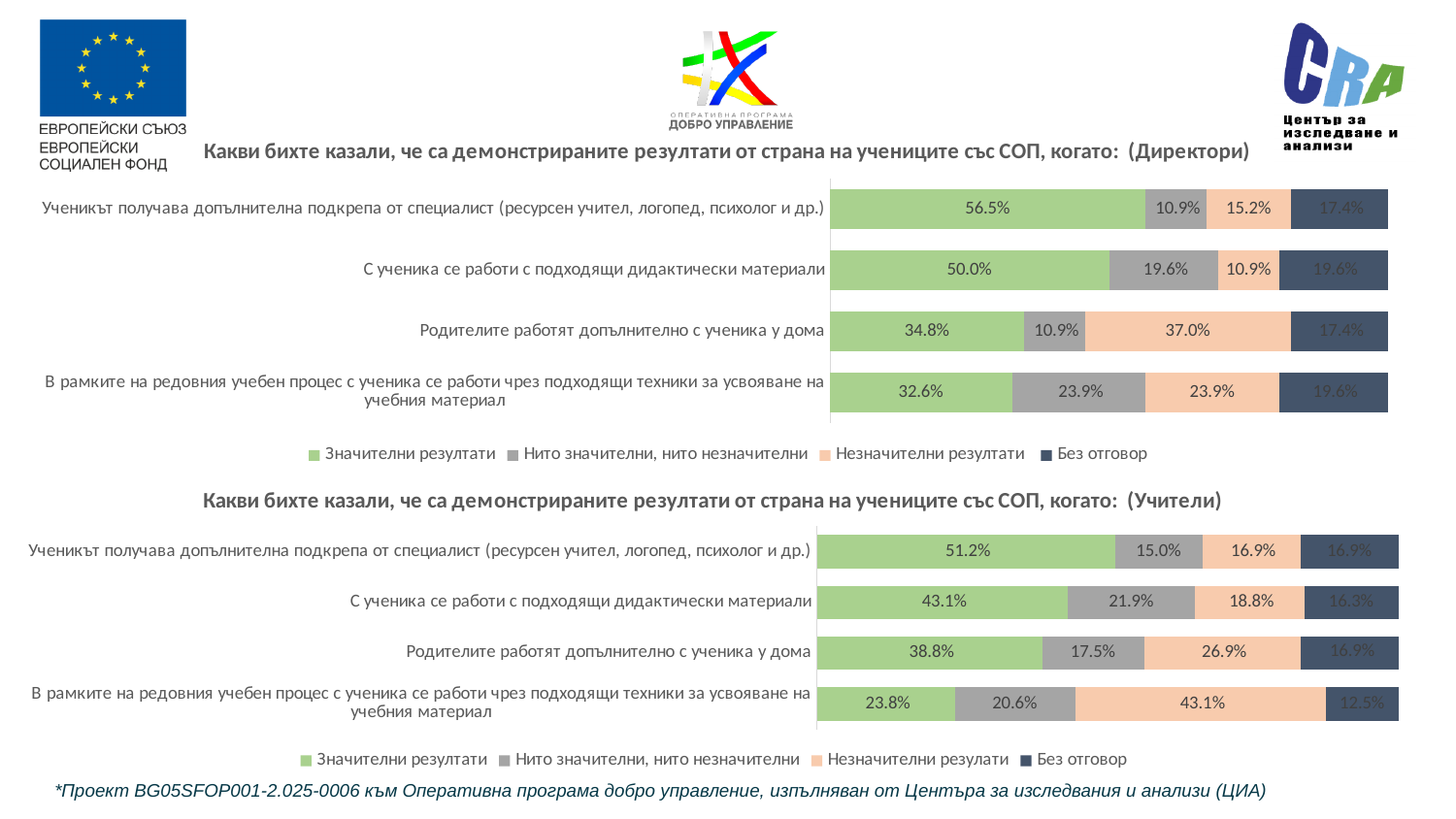
In the chart titled "(Учители)", which is larger for "Родителите работят допълнително с ученика у дома": "Значителни резултати" or "Незначителни резултати"? Значителни резултати In the chart titled "(Учители)", what is the value of "Незначителни резултати" for "В рамките на редовния учебен процес с ученика се работи чрез подходящи техники за усвояване на учебния материал"? 43.1% In the chart titled "(Учители)", what is the value of "Без отговор" for "С ученика се работи с подходящи дидактически материали"? 16.3% In the chart titled "(Учители)", which category has the lowest value for "Значителни резултати"? В рамките на редовния учебен процес с ученика се работи чрез подходящи техники за усвояване на учебния материал In the chart titled "(Учители)", what is the difference between the "Незначителни резултати" values for "В рамките на редовния учебен процес с ученика се работи чрез подходящи техники за усвояване на учебния материал" and "Ученикът получава допълнителна подкрепа от специалист (ресурсен учител, логопед, психолог и др.)"? 26.2% In the chart titled "(Директори)", what is the value of "Нито значителни, нито незначителни" for "В рамките на редовния учебен процес с ученика се работи чрез подходящи техники за усвояване на учебния материал"? 23.9% What kind of chart is the chart titled "(Директори)"? Stacked bar chart In the chart titled "(Директори)", what is the difference between the "Значителни резултати" values for "С ученика се работи с подходящи дидактически материали" and "Родителите работят допълнително с ученика у дома"? 15.2% In the chart titled "(Директори)", what is the value of "Значителни резултати" for "Ученикът получава допълнителна подкрепа от специалист (ресурсен учител, логопед, психолог и др.)"? 56.5% How many series does the legend of the chart titled "(Директори)" list? 4 In the chart titled "(Директори)", which category has the highest value for "Значителни резултати"? Ученикът получава допълнителна подкрепа от специалист (ресурсен учител, логопед, психолог и др.) How many categories are shown in the chart titled "(Учители)"? 4